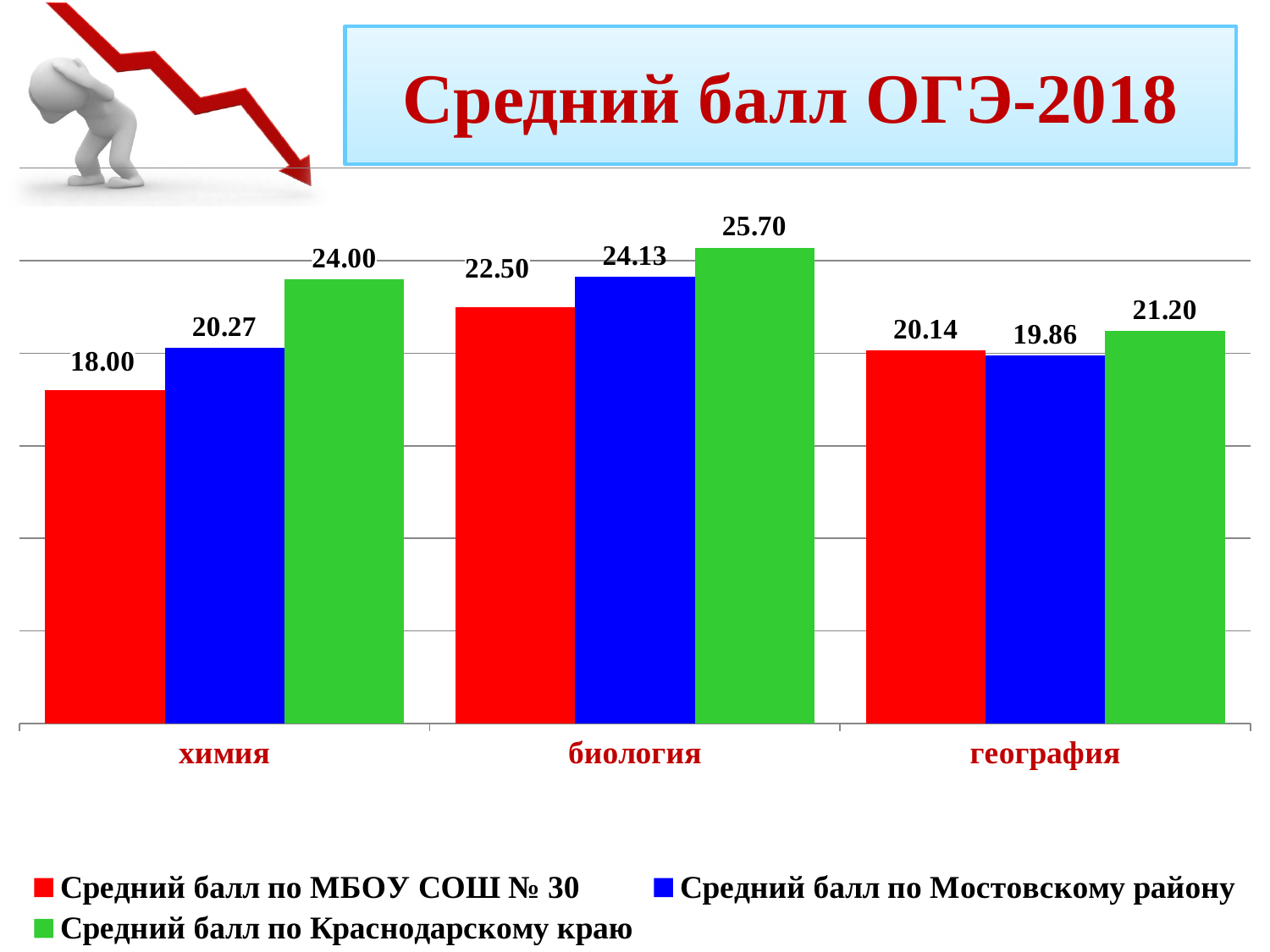
How many series does the legend list? 3 In география, which is larger: the average score for МБОУ СОШ № 30 or for Мостовский район? МБОУ СОШ № 30 What is the average score for Мостовский район in география? 19.86 What is the average score for МБОУ СОШ № 30 in химия? 18.00 How many subjects are shown on the x axis? 3 What is the average score for Краснодарский край in биология? 25.70 What kind of chart is shown on the slide? bar chart What colour are the bars for Средний балл по Краснодарскому краю? green Which subject has the lowest average score for МБОУ СОШ № 30? химия What is the difference between the Краснодарский край and МБОУ СОШ № 30 average scores in химия? 6.00 What is the difference between the Мостовский район and МБОУ СОШ № 30 average scores in биология? 1.63 Which subject has the highest average score for Краснодарский край? биология